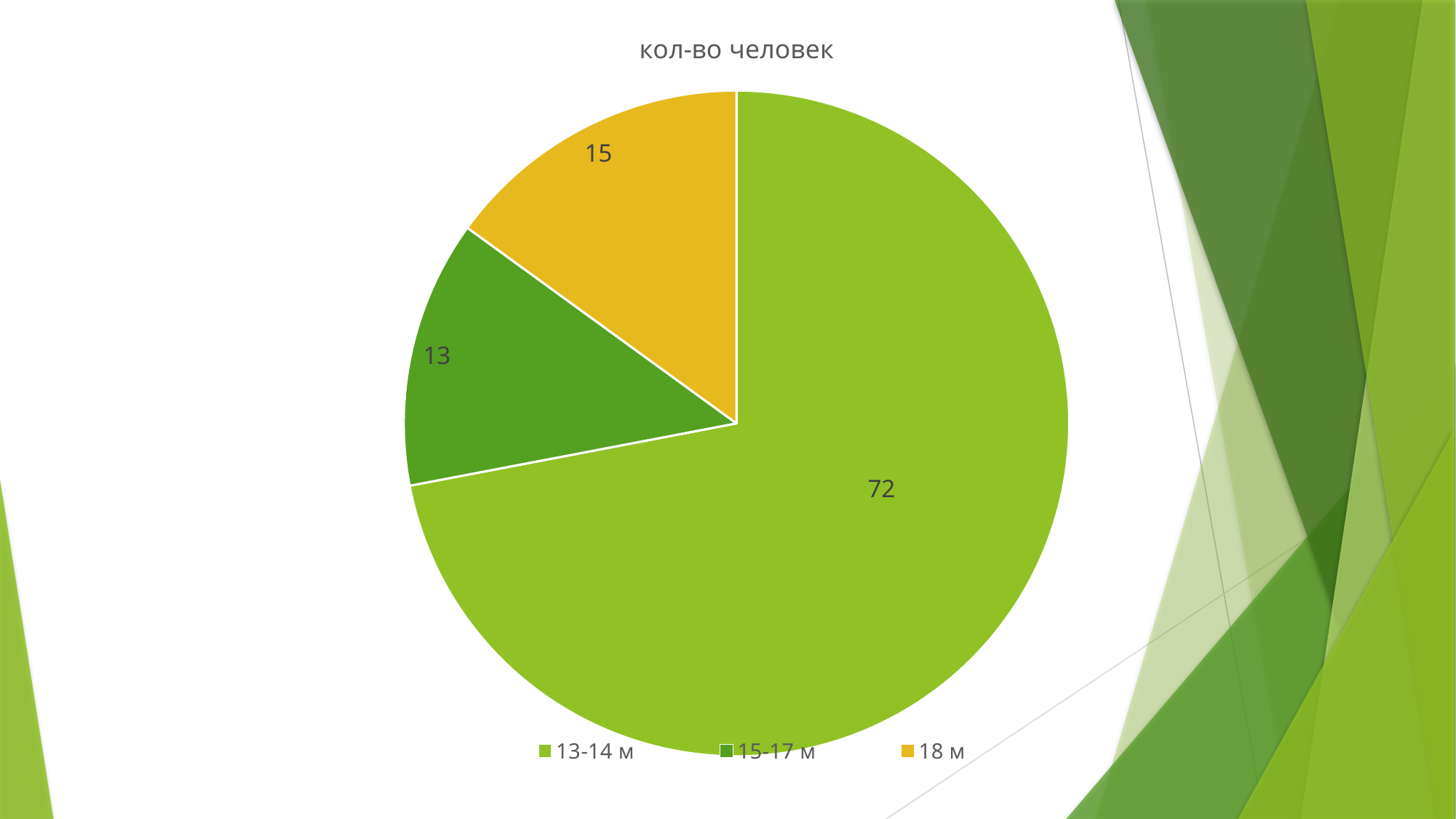
Which category has the largest slice? 13-14 м How many slices does the pie chart have? 3 What is the value for the 18 м slice? 15 Which category has the smallest slice? 15-17 м What is the difference between the values for 13-14 м and 18 м? 57 What is the title of the chart? кол-во человек How many entries does the legend list? 3 What is the value for the 13-14 м slice? 72 What type of chart is shown on the slide? pie chart What share of the pie does the 13-14 м slice represent? 72% Which is larger, the value for 18 м or the value for 15-17 м? 18 м What is the value for the 15-17 м slice? 13